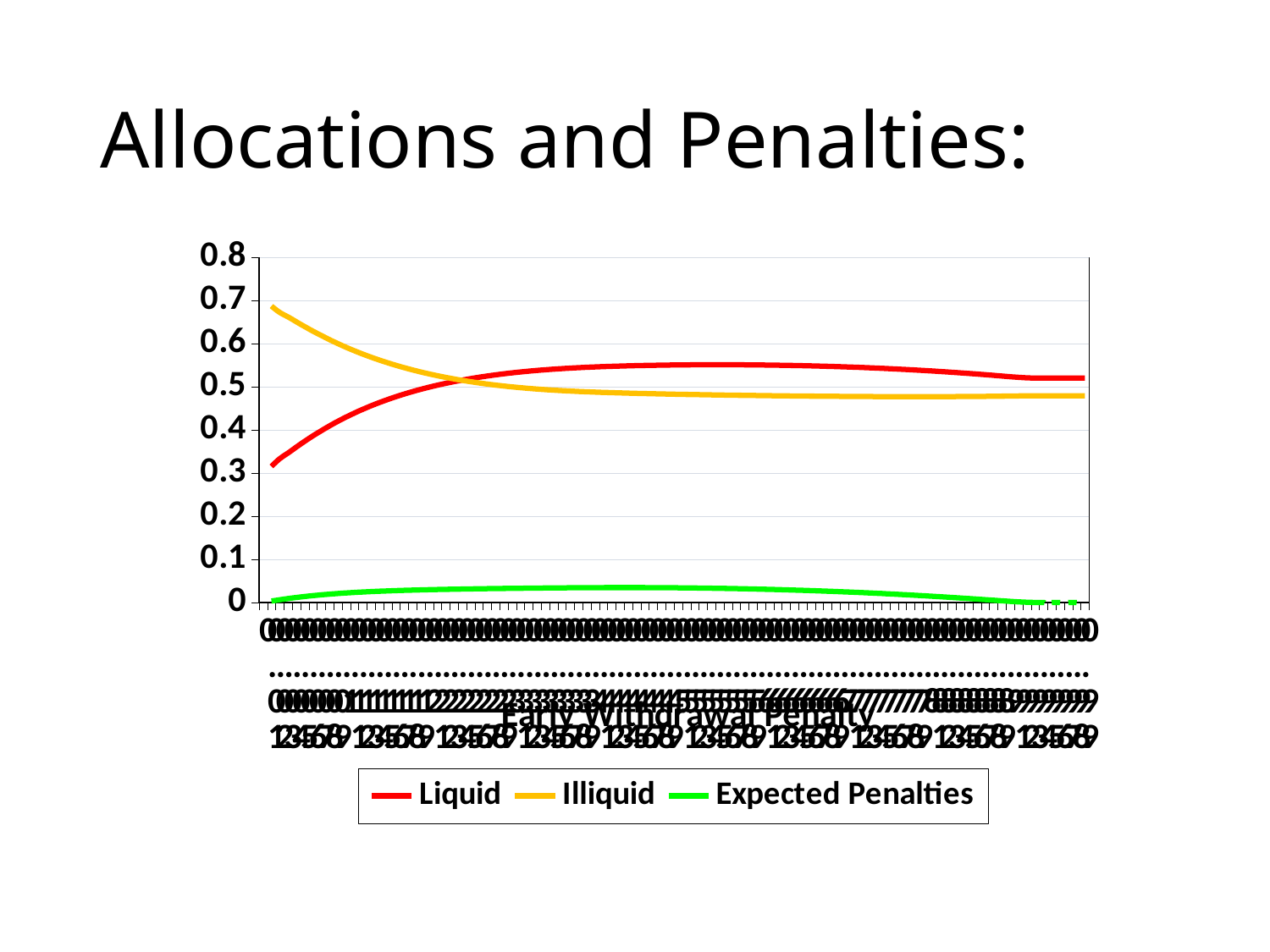
At the right edge of the chart, which series is higher, Liquid or Illiquid? Liquid How many series does the legend list? 3 Does the Illiquid series rise or fall from the left edge of the chart to the right edge? falls What are the three series named in the legend? Liquid, Illiquid, Expected Penalties Which series has the lowest values across the whole chart? Expected Penalties What kind of chart is shown on the slide? line chart Is the Expected Penalties series greater or less than 0.1 across the whole chart? less Is the value of the Liquid series at the left edge of the chart greater or less than 0.4? less At the left edge of the chart, which series is higher, Liquid or Illiquid? Illiquid Is the value of the Illiquid series at the left edge of the chart greater or less than 0.6? greater What colour is the Liquid series line? red Does the Liquid series rise or fall from the left edge of the chart to the right edge? rises